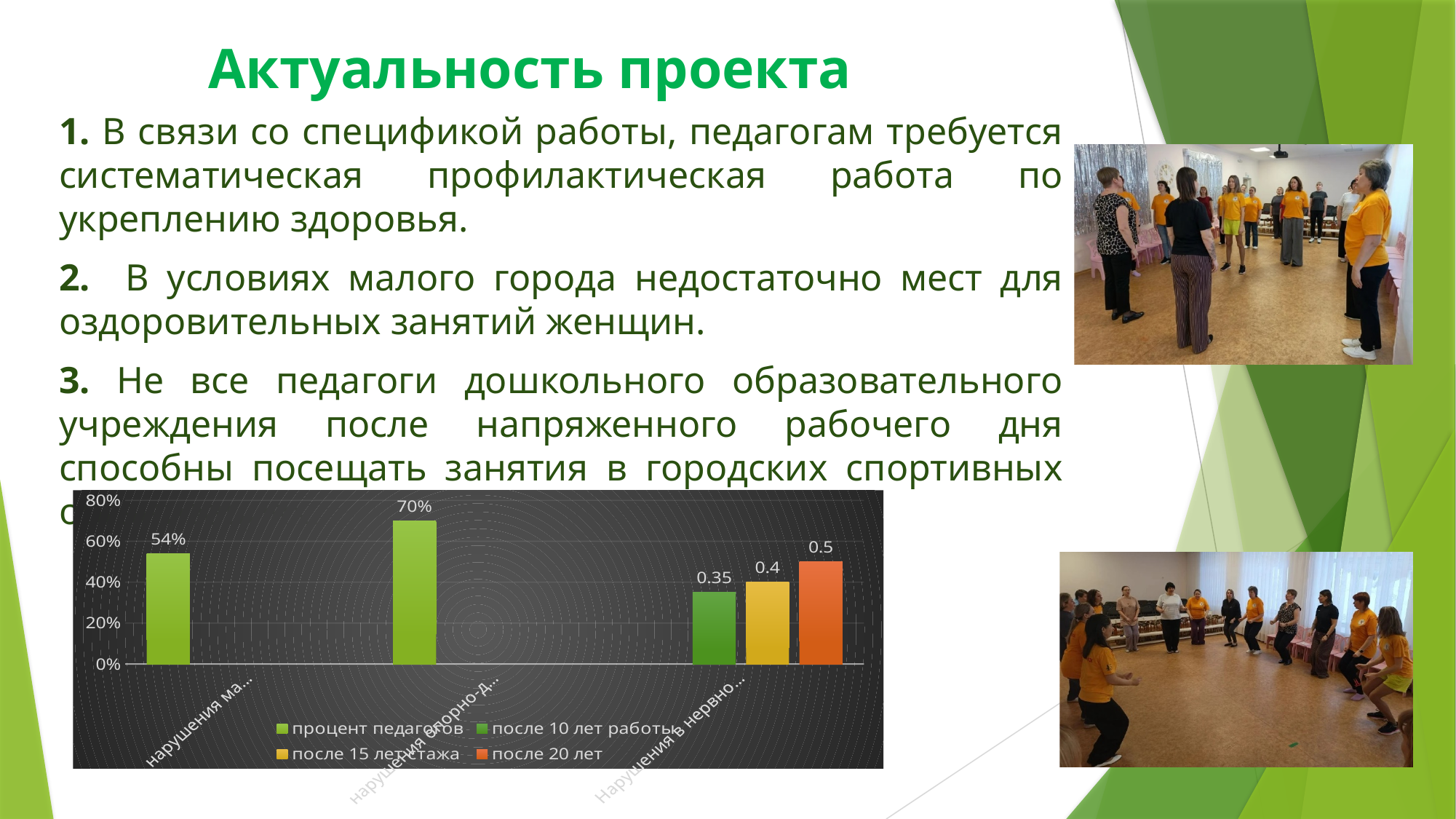
What kind of chart is shown on the slide? bar chart Which bar is larger: "после 20 лет" or "после 15 лет стажа"? после 20 лет How many bars are plotted in the chart? 5 What is the value shown on the second bar from the left in the chart? 70% What colour is used for the series "после 20 лет" in the chart? orange How many series does the chart legend list? 4 What is the value of the bar for the series "после 15 лет стажа"? 0.4 Is the value of the leftmost bar greater or less than 40%? greater What is the value of the bar for the series "после 20 лет"? 0.5 What is the value of the bar for the series "после 10 лет работы"? 0.35 What is the difference between the two bars labelled 70% and 54%? 16% What is the value shown on the leftmost bar of the chart? 54%